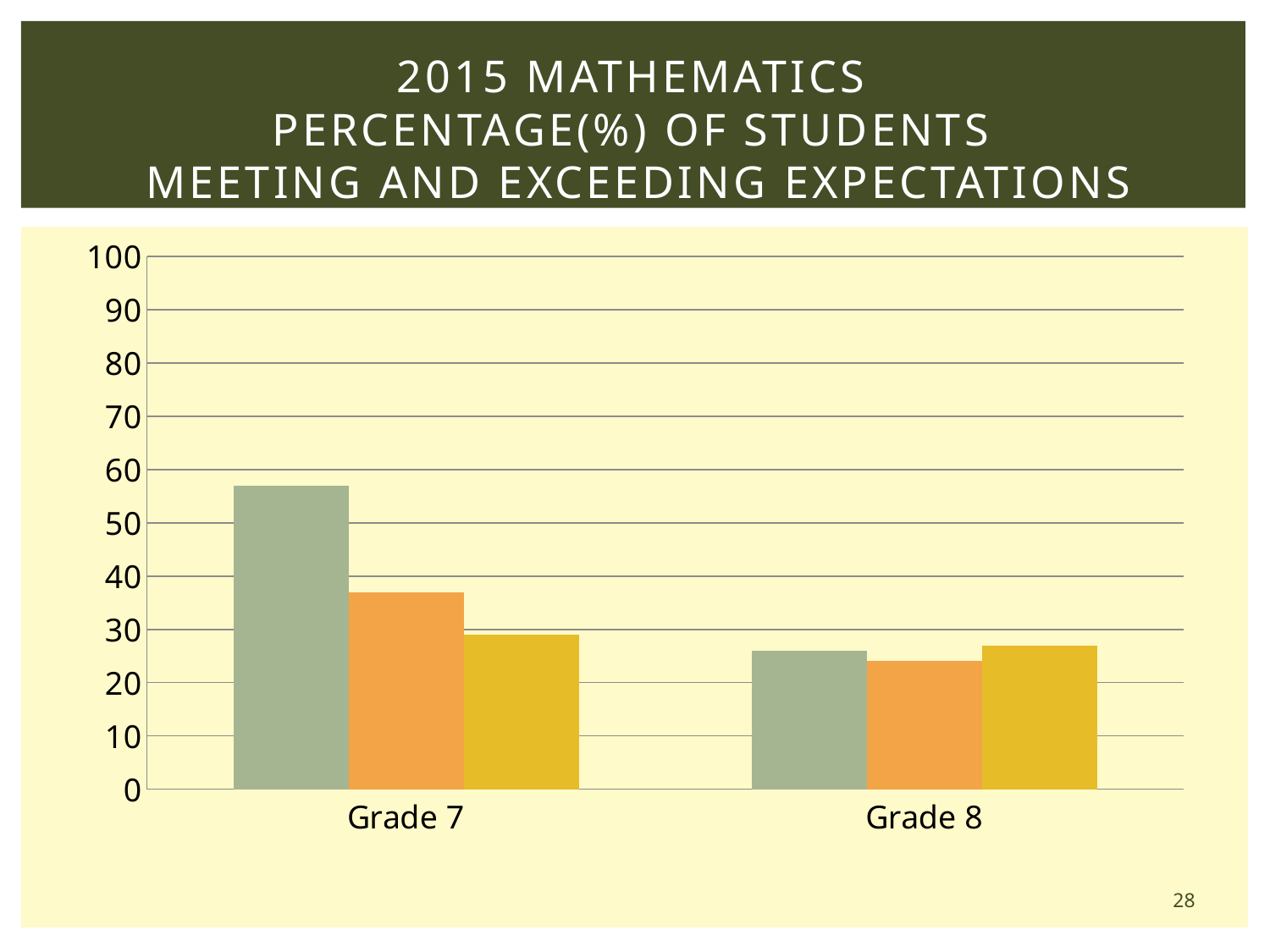
Is the value of the grey-green bar for Grade 8 greater or less than 30? less Which is larger, the grey-green bar for Grade 7 or the grey-green bar for Grade 8? Grade 7 How many grade categories are shown on the x axis? 2 Is the value of the tallest (grey-green) bar for Grade 7 greater or less than 50? greater Is the value of the orange bar for Grade 8 greater or less than 20? greater What kind of chart is shown on the slide? bar chart What is the highest value shown on the vertical axis? 100 How many bars are plotted for each grade? 3 Which is larger, the orange bar for Grade 7 or the orange bar for Grade 8? Grade 7 Which grade has the tallest bar on the chart? Grade 7